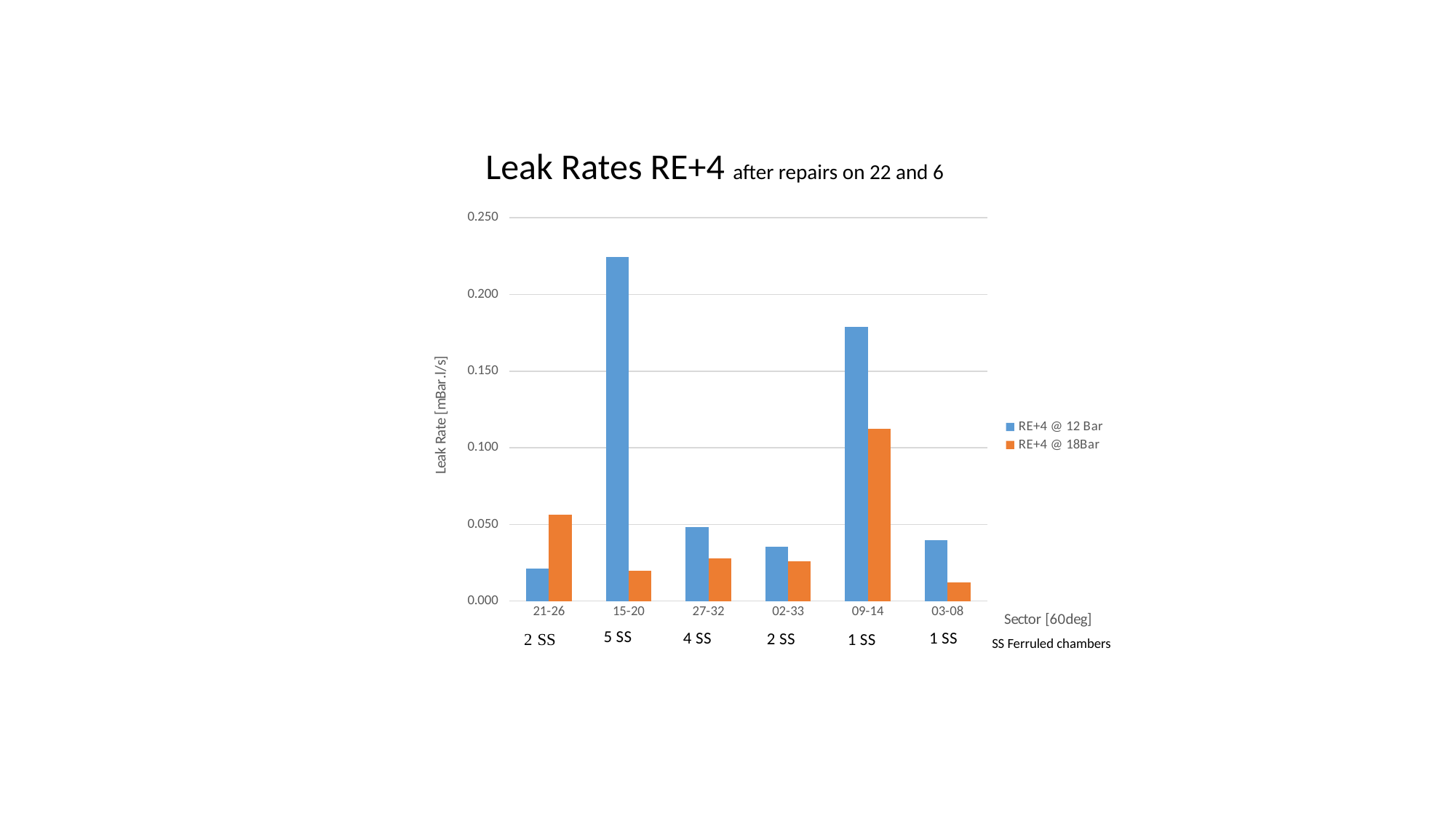
Which sector has the highest value for RE+4 @ 12 Bar? 15-20 Is the value for RE+4 @ 12 Bar in sector 15-20 greater or less than 0.200? greater Which sector has the lowest value for RE+4 @ 18Bar? 03-08 What kind of chart is shown on the slide? bar chart In sector 21-26, which series has the larger value, RE+4 @ 12 Bar or RE+4 @ 18Bar? RE+4 @ 18Bar What is the label of the y axis? Leak Rate [mBar.l/s] How many sectors are shown on the x axis? 6 Is the value for RE+4 @ 18Bar in sector 09-14 greater or less than 0.100? greater How many series does the legend list? 2 Which sector has the highest value for RE+4 @ 18Bar? 09-14 Which sector has the lowest value for RE+4 @ 12 Bar? 21-26